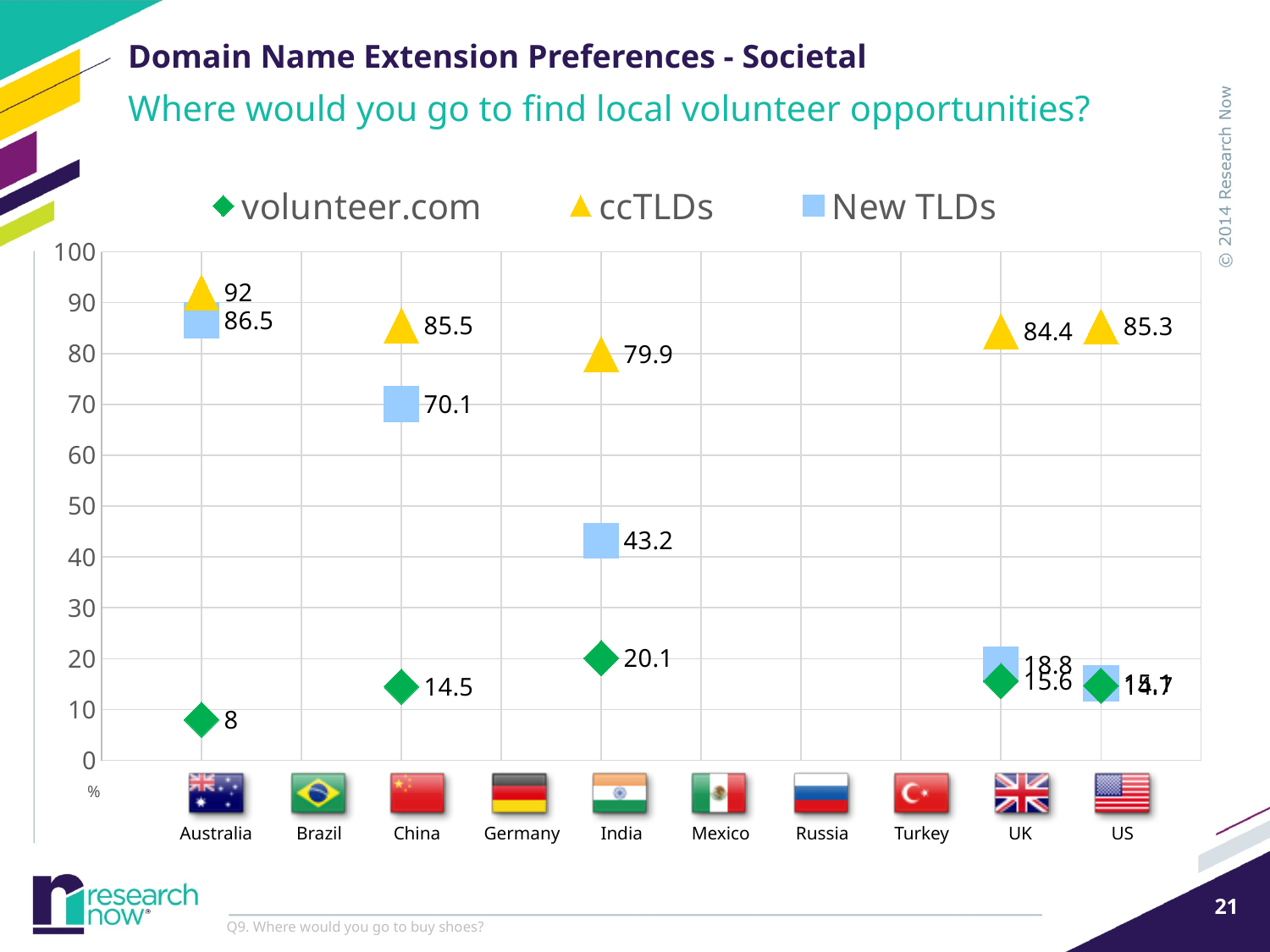
Which country has the highest ccTLDs value? Australia How many series does the legend list? 3 What is the difference between the ccTLDs and New TLDs values for India? 36.7 Which country has the lowest volunteer.com value? Australia Is the New TLDs value for the UK greater or less than 30? less Which marker shape represents the ccTLDs series in the legend? Yellow triangle What is the New TLDs value for China? 70.1 What is the New TLDs value for India? 43.2 What is the ccTLDs value for the UK? 84.4 What is the volunteer.com value for India? 20.1 Which is larger for China: the ccTLDs value or the New TLDs value? ccTLDs What is the ccTLDs value for Australia? 92